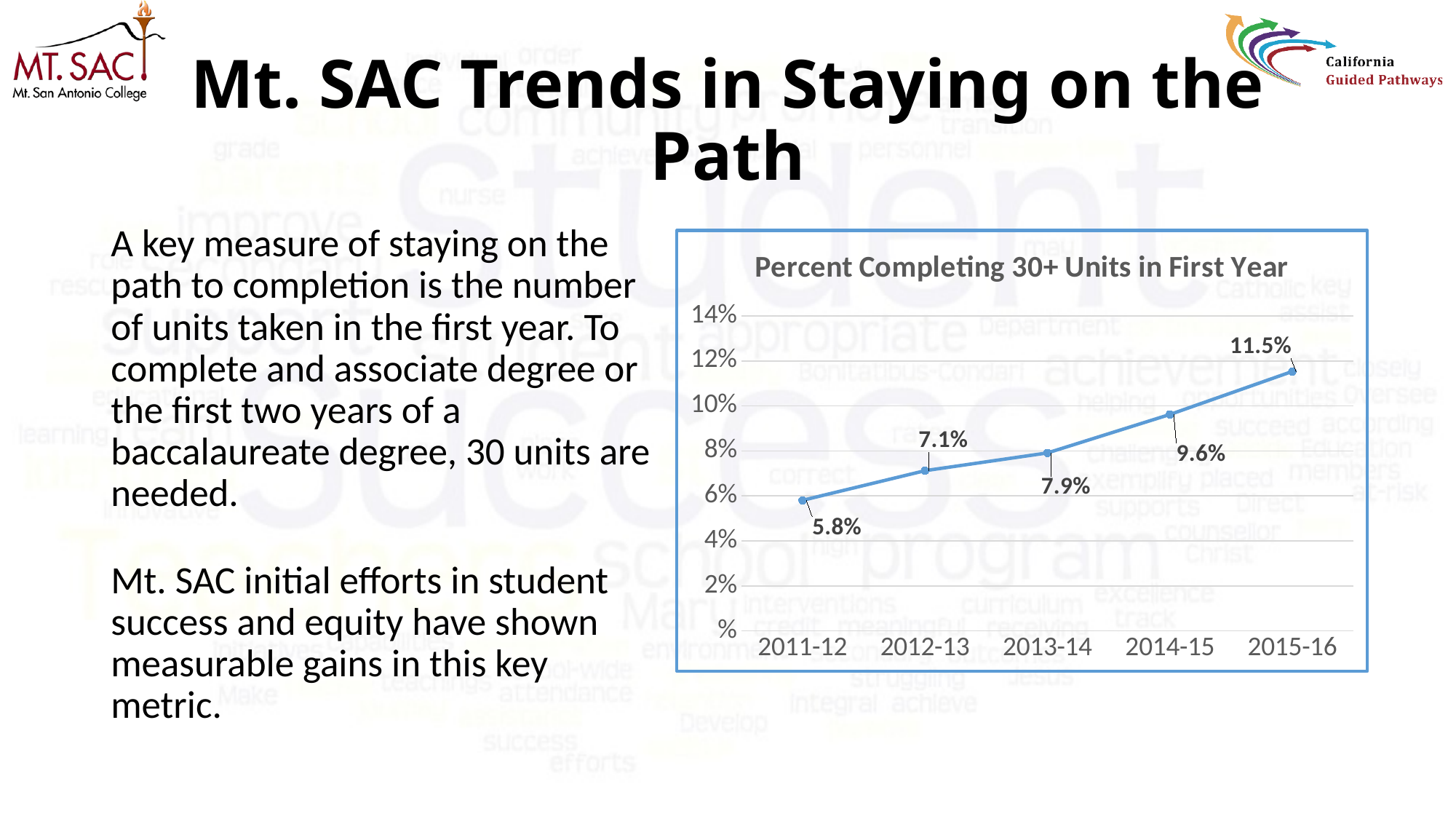
Is the value for 2014-15 greater or less than 10%? less What kind of chart is shown on the slide? line chart Do the values rise or fall from 2011-12 to 2015-16? rise What is the difference between the values for 2015-16 and 2011-12? 5.7% What is the value for 2011-12? 5.8% Which year has the highest percent completing 30+ units in the first year? 2015-16 What is the difference between the values for 2014-15 and 2013-14? 1.7% How many years are plotted on the chart? 5 Which is larger, the value for 2012-13 or the value for 2014-15? 2014-15 What is the value for 2013-14? 7.9% Which year has the lowest percent completing 30+ units in the first year? 2011-12 What is the value for 2015-16? 11.5%